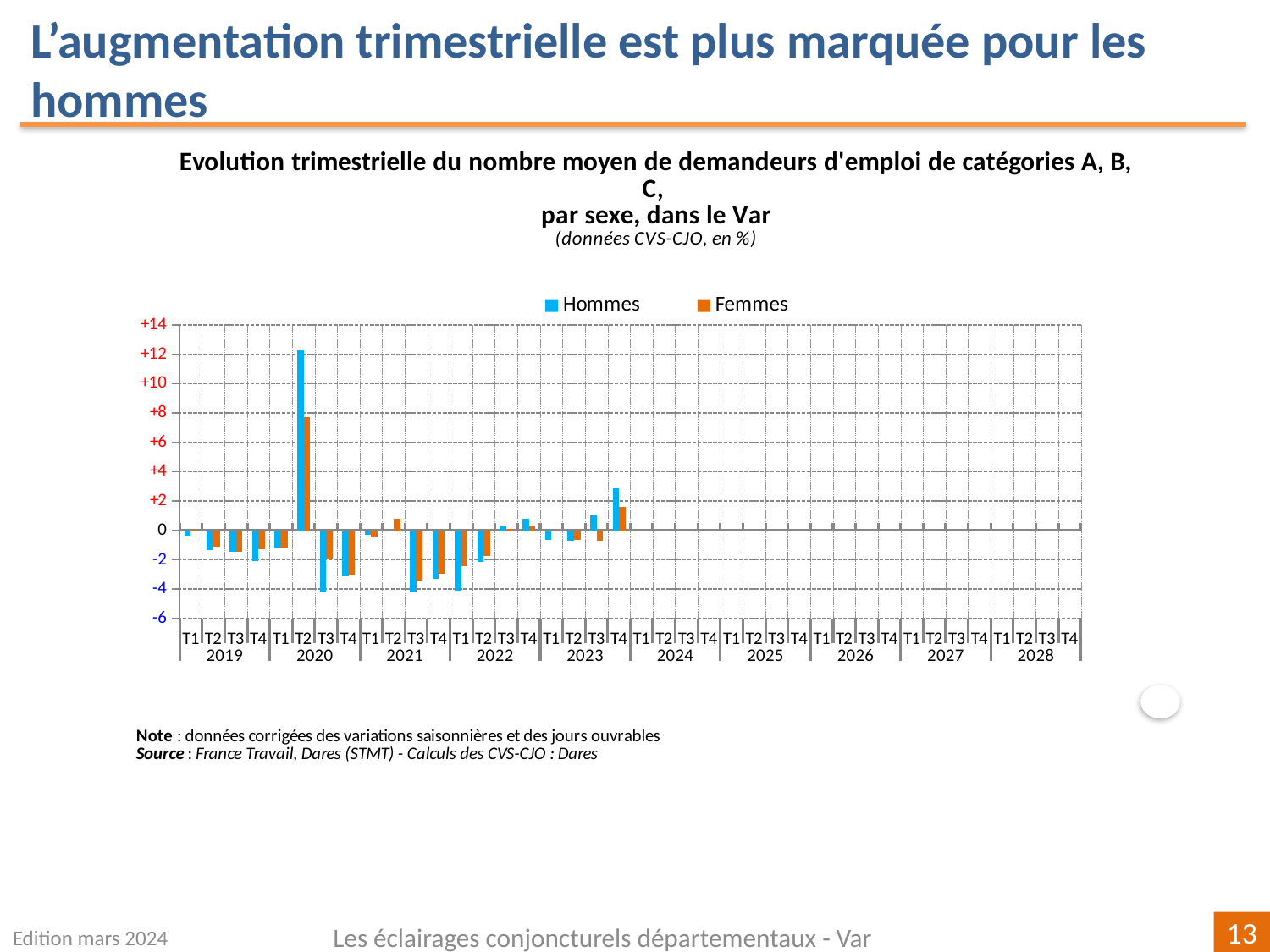
What kind of chart is shown on the slide? bar chart Is the Hommes value for T3 2020 greater or less than -2? less What are the two series named in the legend? Hommes and Femmes How many years are labelled along the x axis? 10 In which quarter does the Hommes series reach its highest value? T2 2020 Is the Hommes value for T4 2023 greater or less than +2? greater Is the Femmes value for T2 2020 greater or less than +6? greater In T4 2023, which series has the larger value, Hommes or Femmes? Hommes In T2 2020, which series has the larger value, Hommes or Femmes? Hommes Which colour represents the Femmes series? orange How many series does the legend list? 2